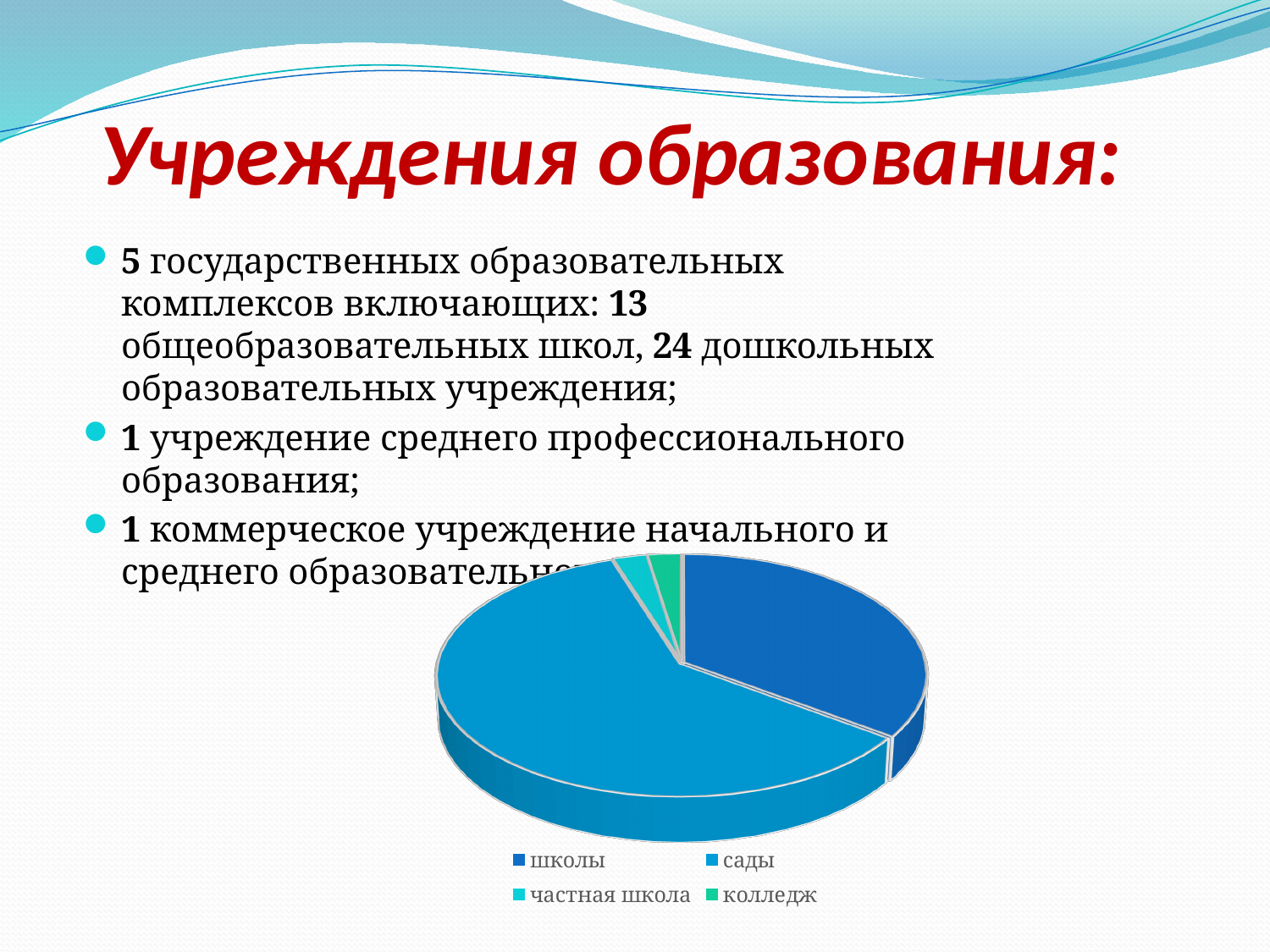
Which category has the largest slice in the pie chart? сады Which slice is larger in the pie chart, школы or сады? сады Which category is shown in the dark blue slice of the pie chart? школы Does the pie chart show any data labels with values on its slices? No Which slice is larger in the pie chart, школы or колледж? школы Which category is shown in the green slice of the pie chart? колледж What kind of chart is shown on the slide? pie chart Which slice is larger in the pie chart, сады or частная школа? сады How many categories does the pie chart's legend list? 4